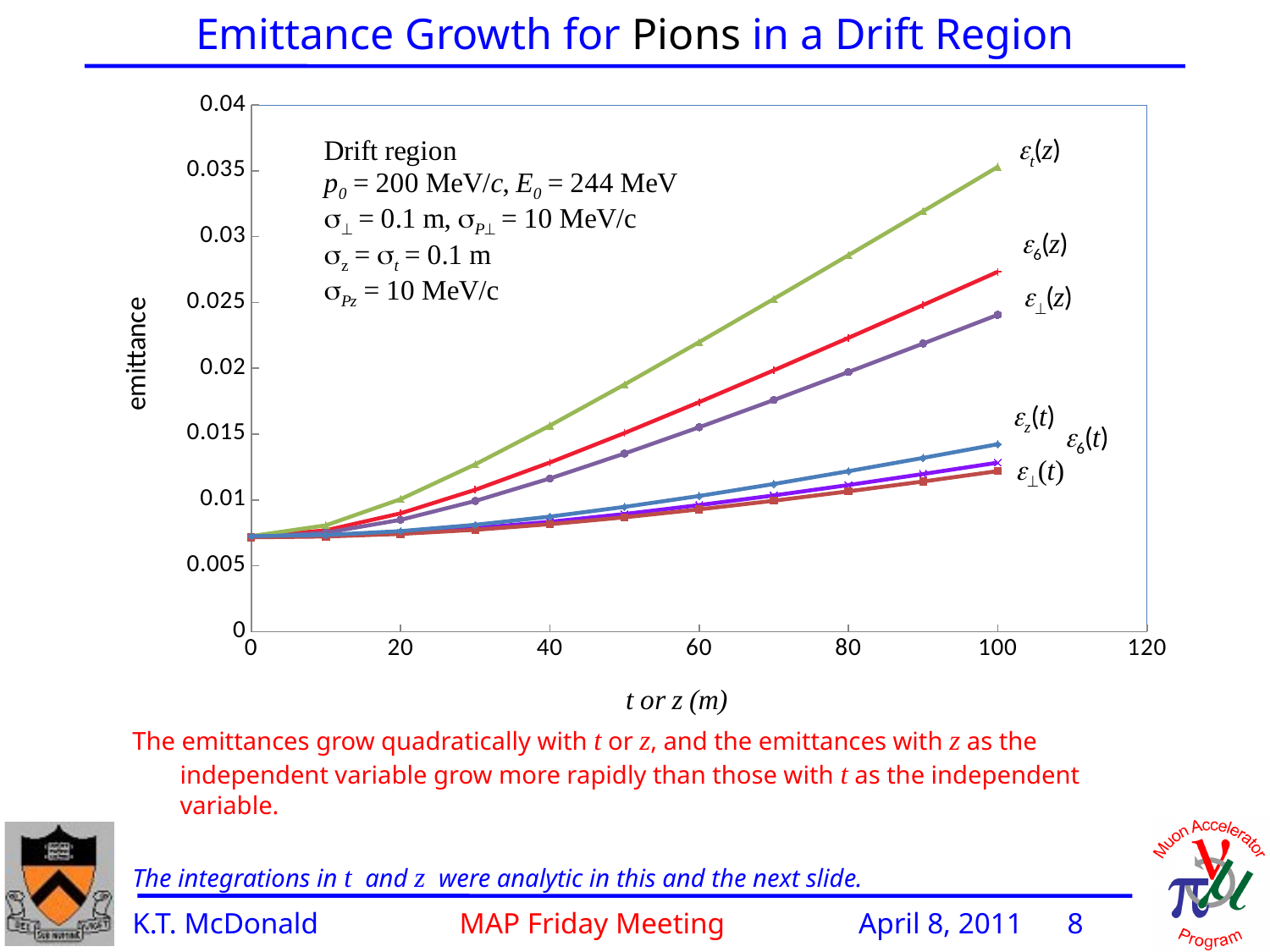
How many curves are plotted on the chart? 6 What kind of chart is shown on the slide? line chart Is the value of ε_6(z) at 100 m greater or less than 0.025? greater What value of p0 is given in the annotation on the chart? 200 MeV/c At t or z = 60 m, which is larger, ε_t(z) or ε_6(z)? ε_t(z) Is the value of ε_z(t) at 100 m greater or less than 0.015? less Is the value of ε_⊥(t) at 100 m greater or less than 0.01? greater Do the emittance curves rise or fall as t or z increases? rise Which curve has the highest emittance at t or z = 100 m? ε_t(z) What is the label of the x axis? t or z (m) Which curve has the lowest emittance at t or z = 100 m? ε_⊥(t)